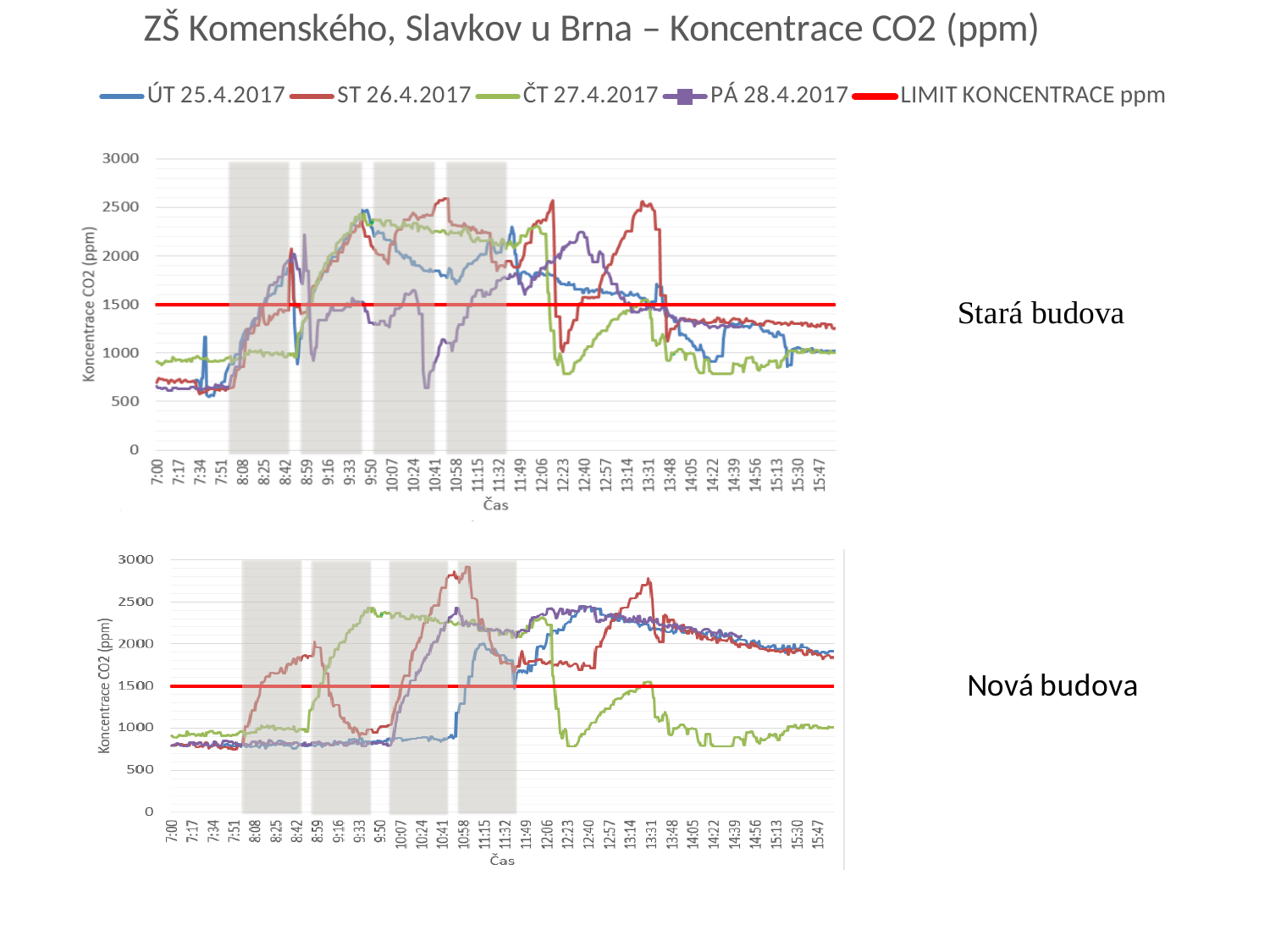
In the Nová budova chart, is the value for ST 26.4.2017 at 10:58 greater or less than 2500? greater How many series does the legend list? 5 At what value is the LIMIT KONCENTRACE ppm line drawn in both charts? 1500 In the Stará budova chart, which series is larger at 12:23, ST 26.4.2017 or PÁ 28.4.2017? PÁ 28.4.2017 In the Nová budova chart, which series is larger at 14:22, ÚT 25.4.2017 or ČT 27.4.2017? ÚT 25.4.2017 What is the x-axis title of the Stará budova chart? Čas In the Stará budova chart, is the value for PÁ 28.4.2017 at 10:41 greater or less than 1000? less What kind of chart is the Stará budova chart? line chart In the Stará budova chart, is the value for ST 26.4.2017 at 7:00 greater or less than 1000? less In the Nová budova chart, which series reaches the highest peak? ST 26.4.2017 What is the y-axis title of the Nová budova chart? Koncentrace CO2 (ppm)